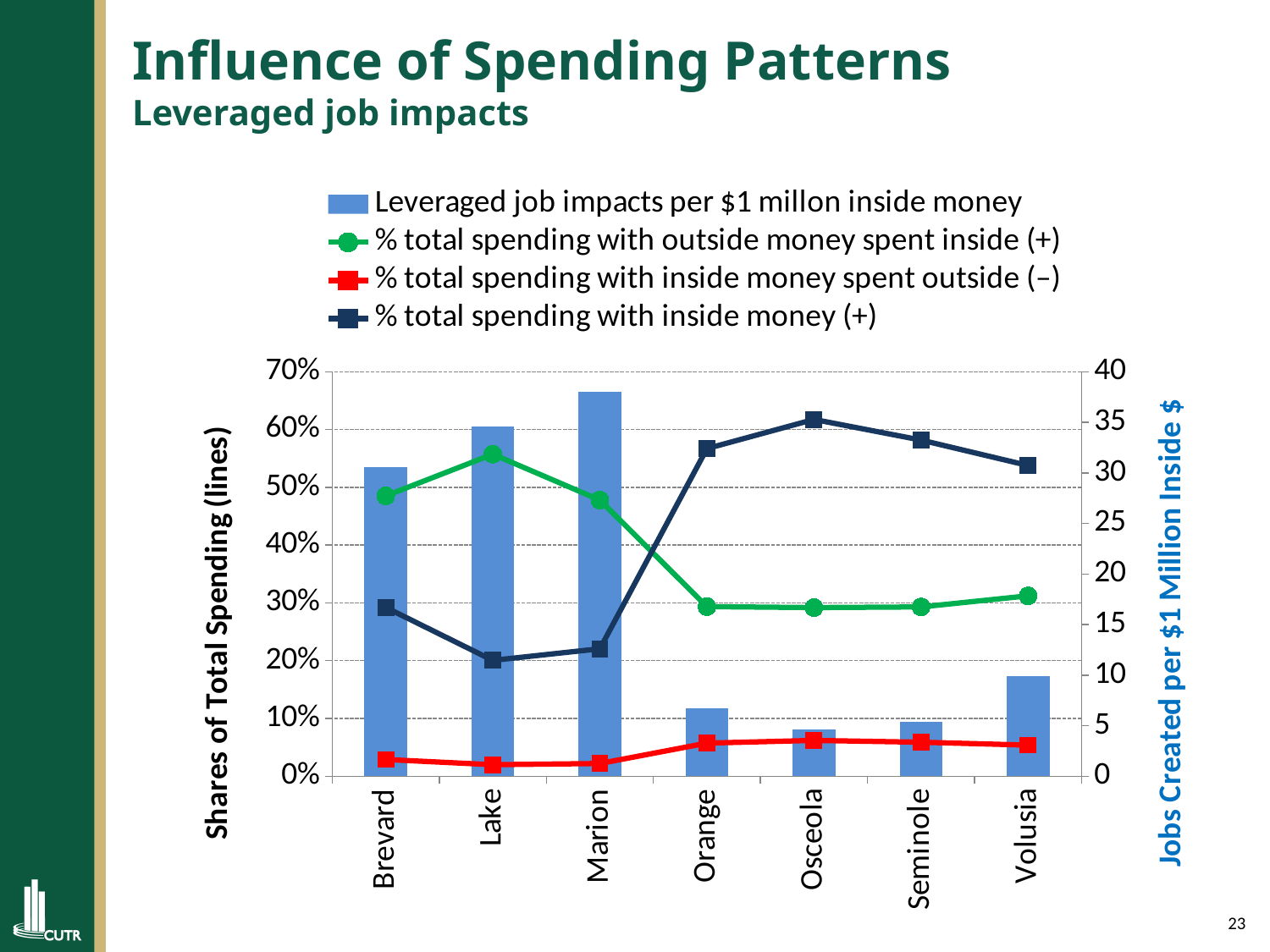
Which county has the tallest bar for leveraged job impacts per $1 million inside money? Marion Is the '% total spending with inside money (+)' value for Lake greater or less than 30%? less What kind of chart is shown on the slide? A combined bar and line chart Is the leveraged job impacts bar for Marion greater or less than 35 on the right axis? greater How many counties are shown along the x axis of the chart? 7 What is the label of the right-hand vertical axis? Jobs Created per $1 Million Inside $ Which county has a taller leveraged job impacts bar, Brevard or Volusia? Brevard How many series does the chart's legend list? 4 Is the '% total spending with outside money spent inside (+)' value for Lake greater or less than 50%? greater Which county has the highest value on the '% total spending with outside money spent inside (+)' line? Lake For Orange, which is larger: '% total spending with inside money (+)' or '% total spending with outside money spent inside (+)'? % total spending with inside money (+) Which county has the highest value on the '% total spending with inside money (+)' line? Osceola